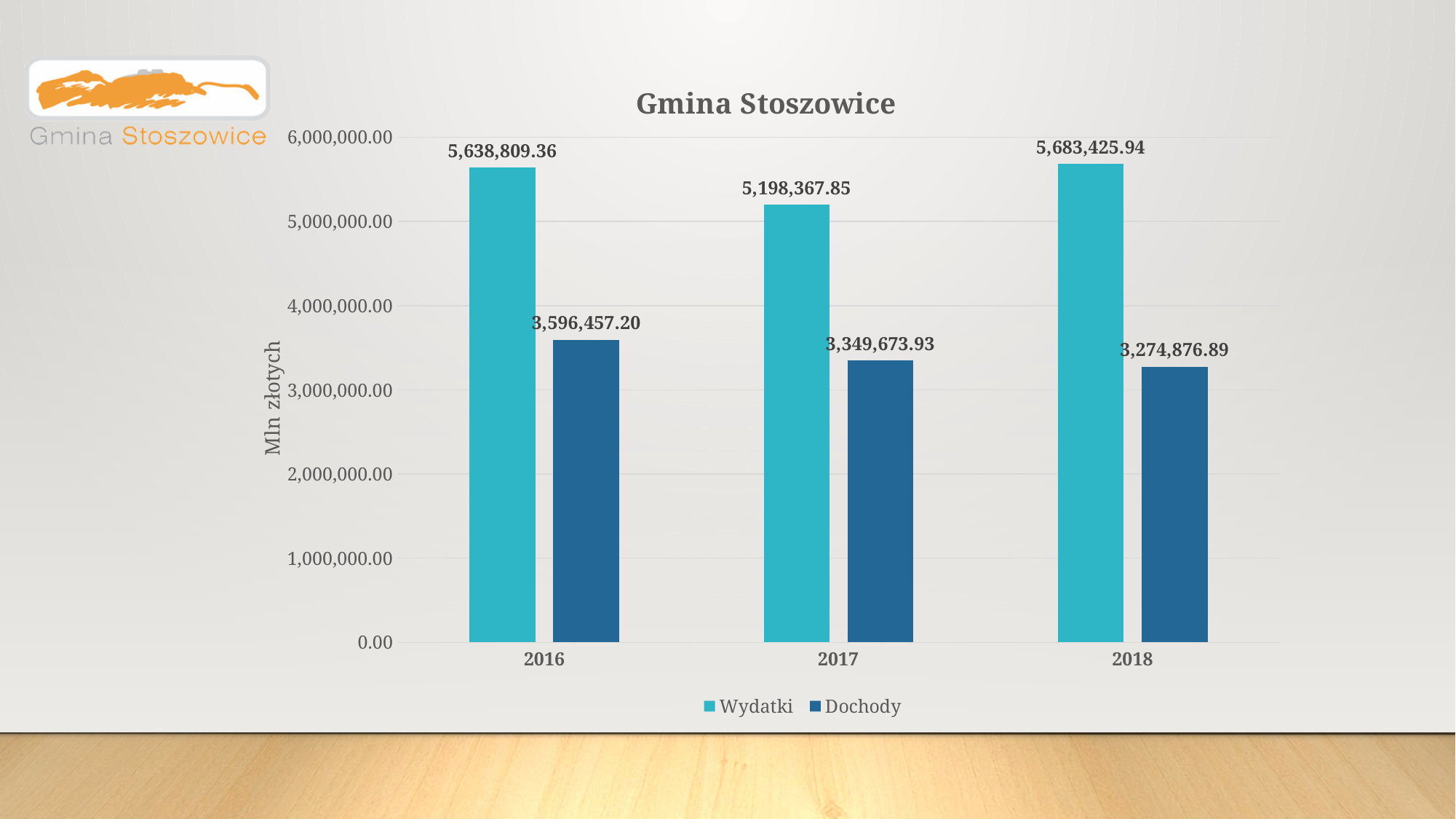
By how much did Dochody fall from 2016 to 2018? 321,580.31 What is the value of Dochody for 2017? 3,349,673.93 What is the value of Wydatki for 2016? 5,638,809.36 How many years are shown on the x axis? 3 What is the difference between Wydatki and Dochody in 2016? 2,042,352.16 How many series does the legend list? 2 Which is larger in 2017, Wydatki or Dochody? Wydatki In which year is Dochody the lowest? 2018 What is the value of Wydatki for 2018? 5,683,425.94 Do the Dochody values rise or fall from 2016 to 2018? fall In which year is Wydatki the highest? 2018 Is the value of Dochody for 2018 greater or less than 3,000,000.00? greater